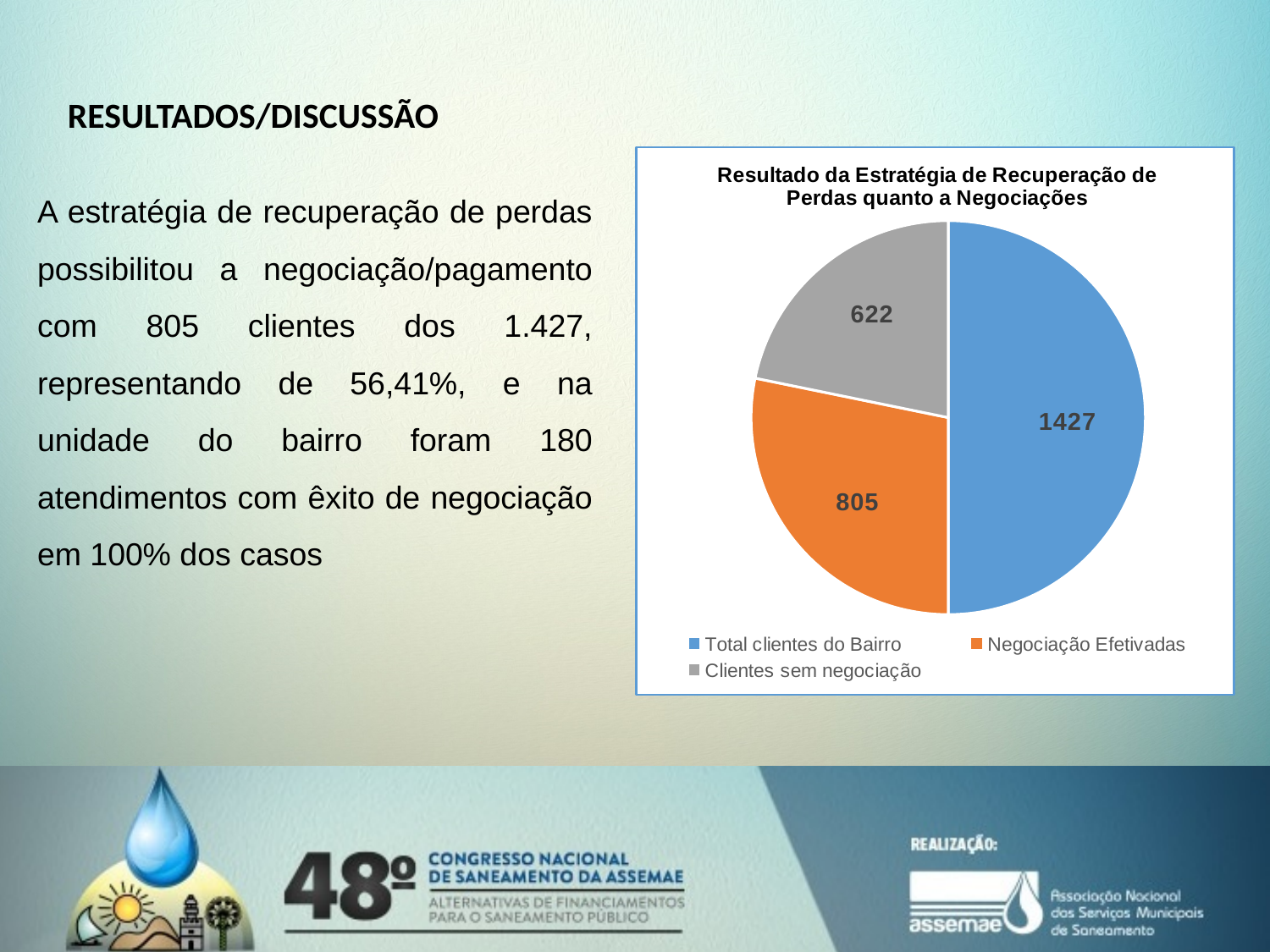
What is the difference between Total clientes do Bairro and Negociação Efetivadas? 622 How many slices does the pie chart have? 3 What is the value for Negociação Efetivadas? 805 What share of the pie does the Total clientes do Bairro slice represent? 50% What is the value for Clientes sem negociação? 622 Which slice has the smallest value? Clientes sem negociação Which is larger, Negociação Efetivadas or Clientes sem negociação? Negociação Efetivadas What is the title of the chart? Resultado da Estratégia de Recuperação de Perdas quanto a Negociações Which slice has the largest value? Total clientes do Bairro What is the value for Total clientes do Bairro? 1427 What is the difference between Negociação Efetivadas and Clientes sem negociação? 183 What type of chart is shown on the slide? pie chart